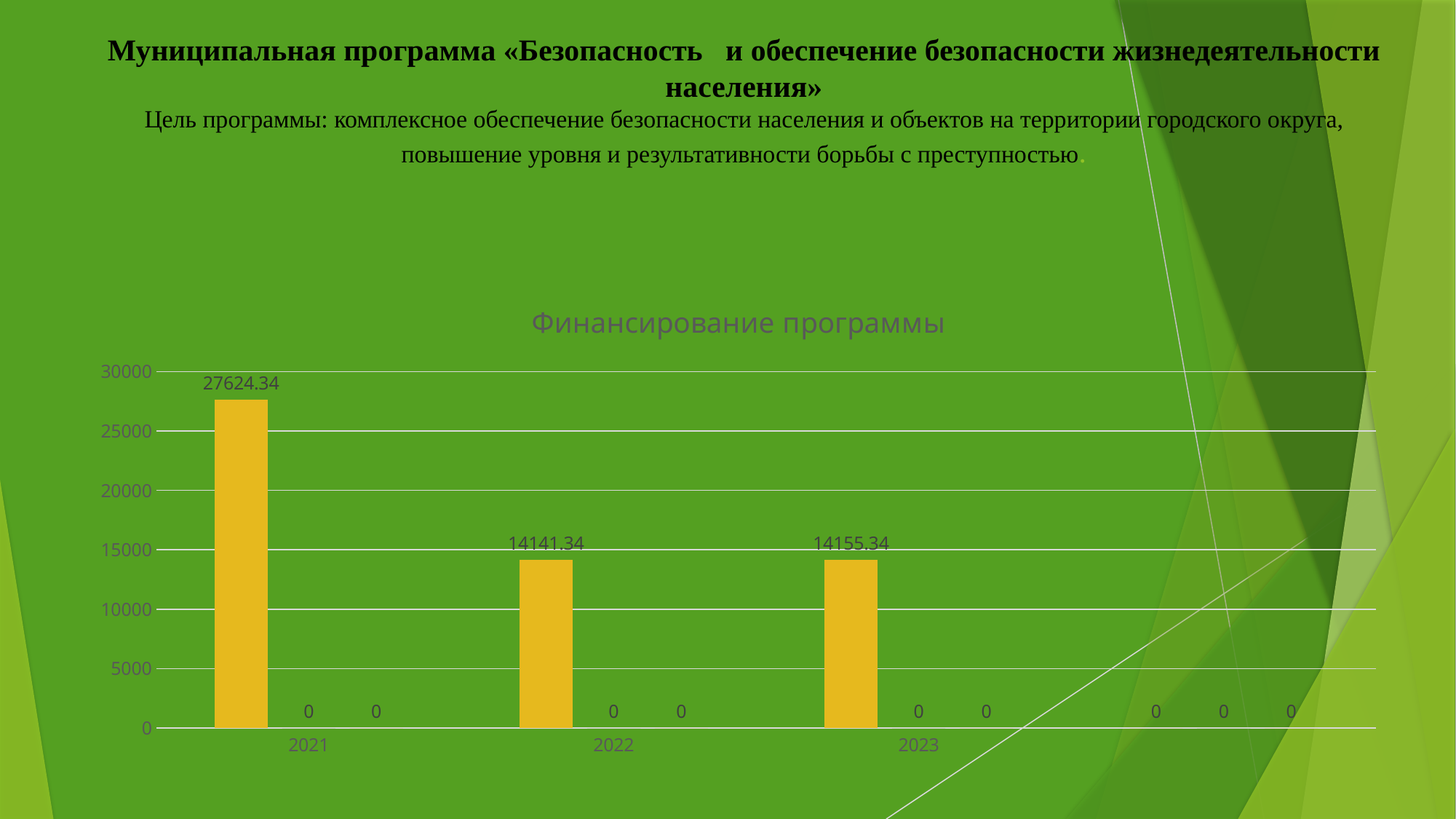
Which is larger, the value for 2022 or the value for 2023? 2023 What is the value of the bar for 2021 in the 'Финансирование программы' chart? 27624.34 Is the value for 2021 greater or less than 25000? greater What is the value of the bar for 2023 in the 'Финансирование программы' chart? 14155.34 What is the value of the bar for 2022 in the 'Финансирование программы' chart? 14141.34 What kind of chart is shown on the slide? bar chart How many years are labeled on the x axis of the chart? 3 What is the difference between the 2021 value and the 2022 value? 13483 What is the title of the chart on the slide? Финансирование программы What is the difference between the 2023 value and the 2022 value? 14 Which year has the lowest non-zero funding value in the chart? 2022 Which year has the highest funding value in the chart? 2021